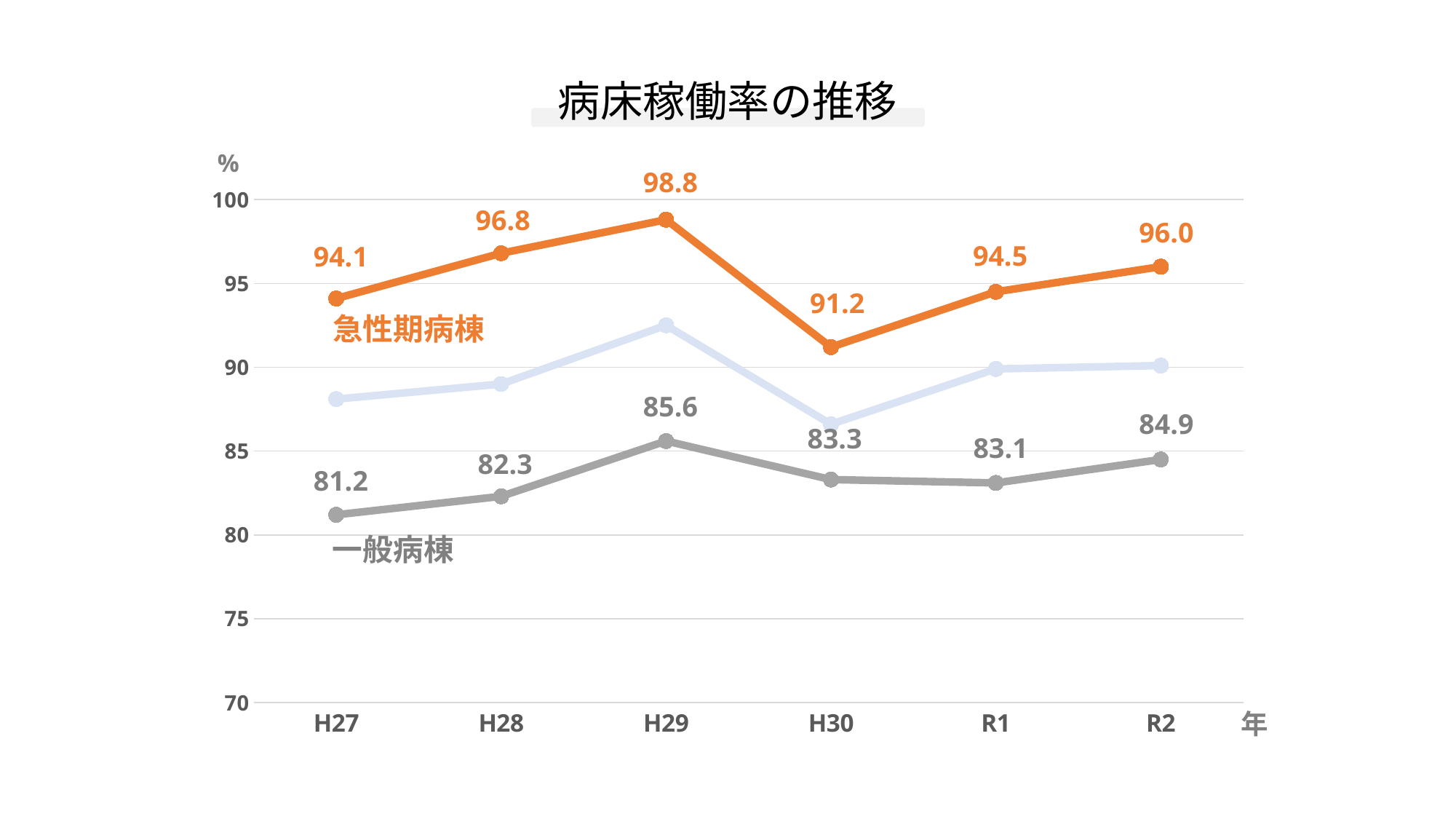
What is the title of the chart? 病床稼働率の推移 Which is larger for 一般病棟: the value in H28 or the value in R1? R1 Does the value for 急性期病棟 rise or fall from H29 to H30? fall What is the value for 急性期病棟 in R2? 96.0 What is the difference between the 急性期病棟 and 一般病棟 values in H27? 12.9 How many years are shown on the x axis? 6 What is the value for 一般病棟 in H30? 83.3 What type of chart is shown on the slide? line chart In which year is the value for 急性期病棟 the lowest? H30 What colour is the line for 急性期病棟? orange In which year is the value for 一般病棟 the highest? H29 What is the value for 急性期病棟 in H29? 98.8